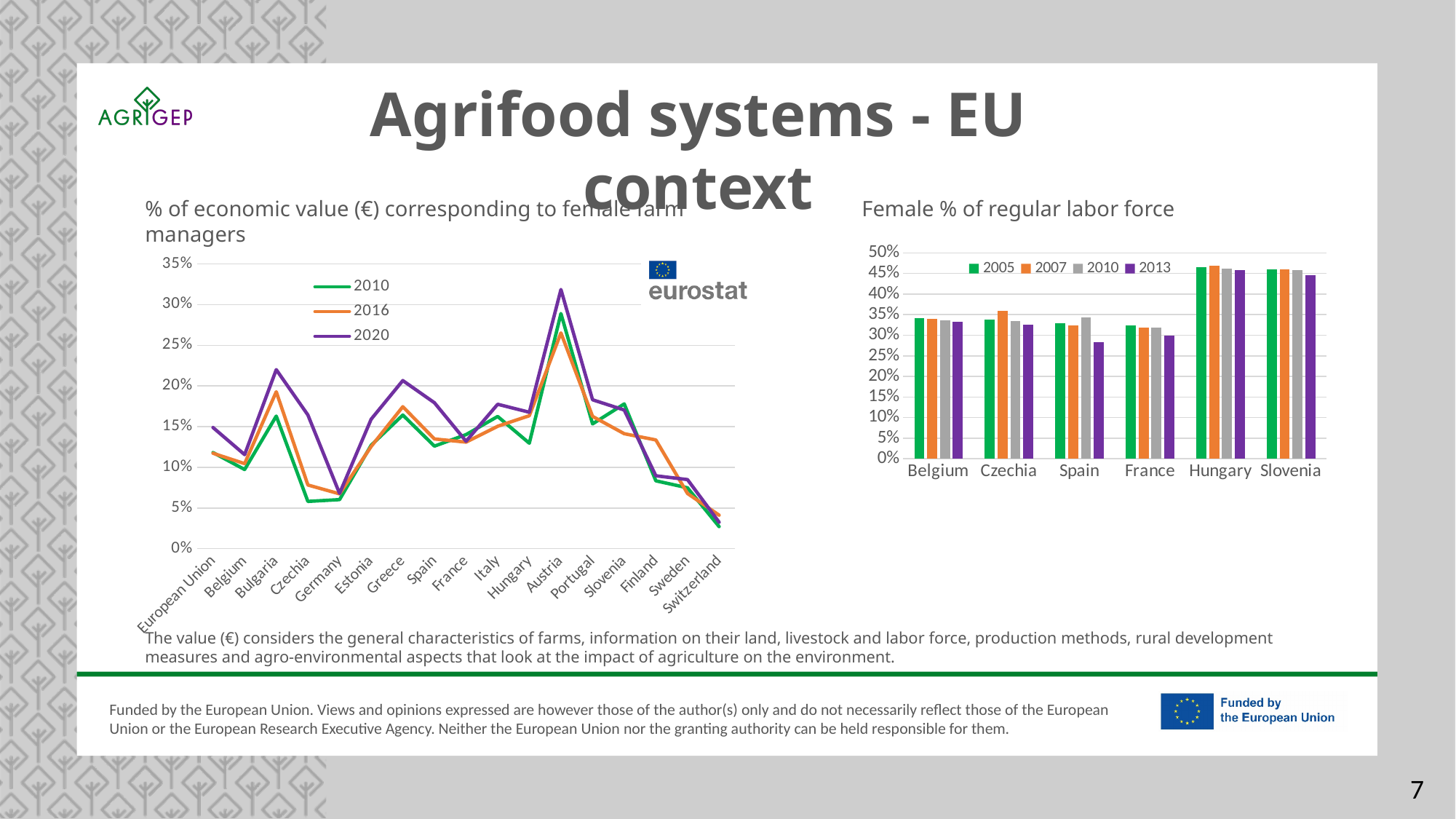
What kind of chart is the chart titled 'Female % of regular labor force'? bar chart How many series does the legend list in the '% of economic value (€) corresponding to female farm managers' chart? 3 In the 'Female % of regular labor force' chart, is the 2013 value for Spain greater or less than 30%? less In the '% of economic value (€) corresponding to female farm managers' chart, which country has the highest value for 2020? Austria In the '% of economic value (€) corresponding to female farm managers' chart, which country has the lowest value for 2020? Switzerland How many categories are shown on the x axis of the '% of economic value (€) corresponding to female farm managers' chart? 17 In the '% of economic value (€) corresponding to female farm managers' chart, is the 2010 value for Czechia greater or less than 10%? less In the '% of economic value (€) corresponding to female farm managers' chart, is the 2020 value for Austria greater or less than 30%? greater How many series does the legend list in the 'Female % of regular labor force' chart? 4 How many countries are shown on the x axis of the 'Female % of regular labor force' chart? 6 In the 'Female % of regular labor force' chart, which is larger for 2013: Hungary or France? Hungary What kind of chart is the chart titled '% of economic value (€) corresponding to female farm managers'? line chart